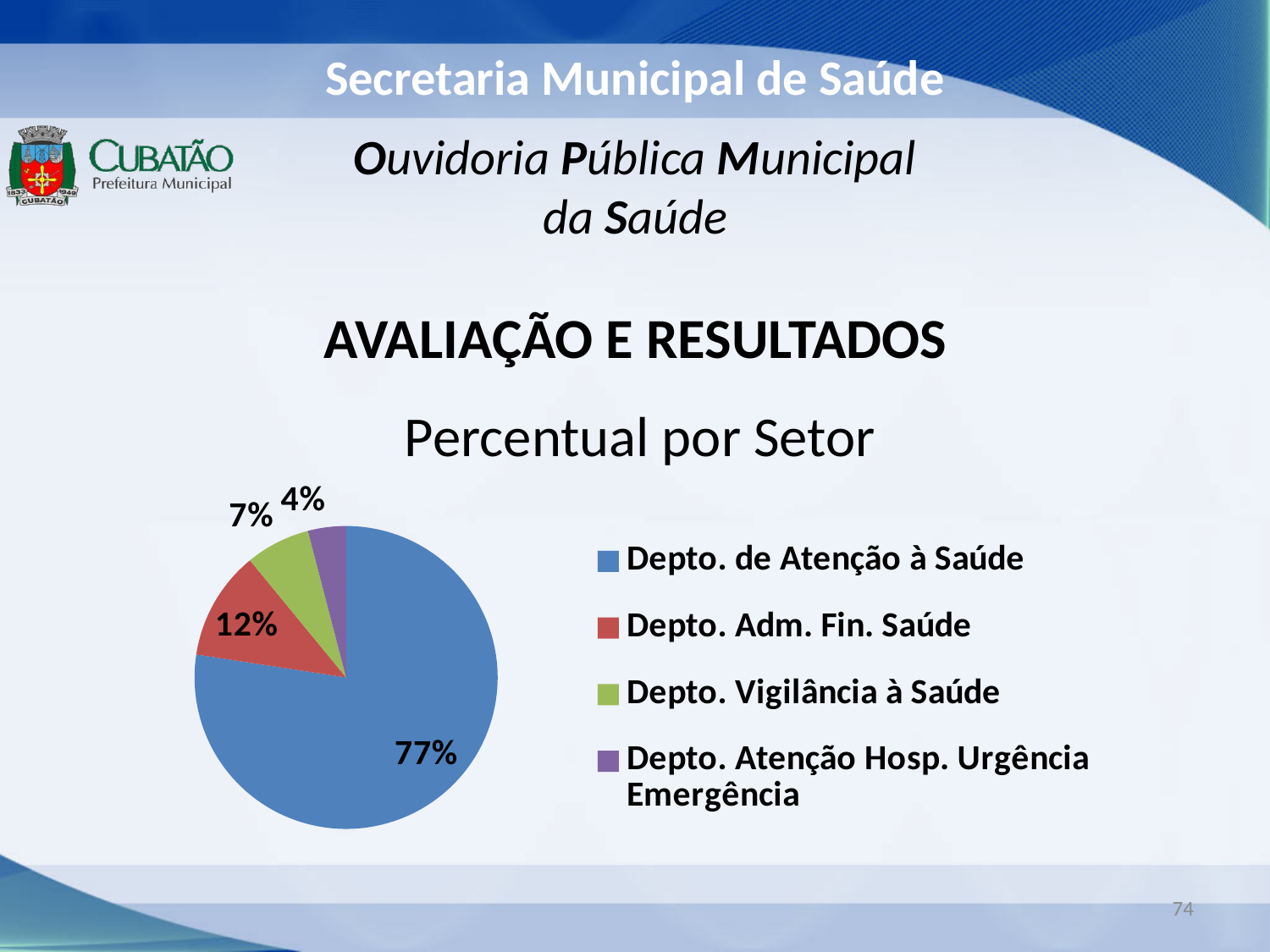
How many sectors are shown in the pie chart? 4 Which is larger, the share for Depto. Vigilância à Saúde or Depto. Atenção Hosp. Urgência Emergência? Depto. Vigilância à Saúde What percentage does Depto. Vigilância à Saúde account for? 7% What percentage does Depto. Adm. Fin. Saúde account for? 12% What is the chart's title? Percentual por Setor Which sector has the largest share of the pie? Depto. de Atenção à Saúde What percentage does Depto. de Atenção à Saúde account for? 77% What is the difference in percentage points between Depto. de Atenção à Saúde and Depto. Adm. Fin. Saúde? 65 Which sector has the smallest share of the pie? Depto. Atenção Hosp. Urgência Emergência What type of chart is shown on the slide? pie chart What colour is the slice for Depto. Adm. Fin. Saúde? red What percentage does Depto. Atenção Hosp. Urgência Emergência account for? 4%